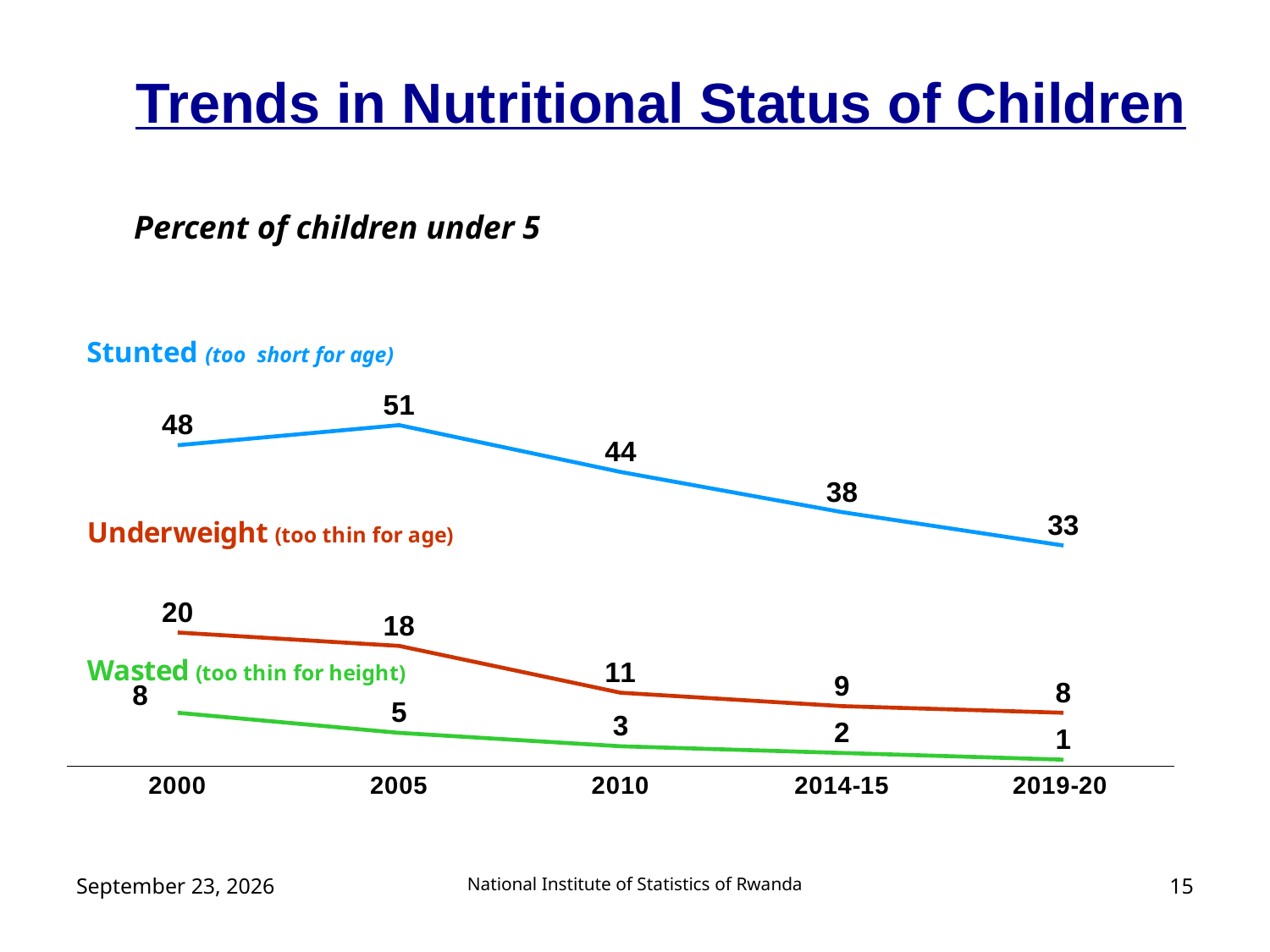
Does the wasted percentage rise or fall from 2000 to 2019-20? fall In which year is the underweight percentage lowest? 2019-20 What kind of chart is shown on the slide? line chart What is the underweight percentage in 2010? 11 In which year is the stunted percentage highest? 2005 Which is larger: the underweight percentage in 2005 or in 2014-15? 2005 What is the difference between the stunted percentage in 2000 and in 2019-20? 15 What is the wasted percentage in 2019-20? 1 How many series are plotted on the chart? 3 What colour is the line for the stunted series? blue How many time points are plotted on the x axis? 5 What is the stunted percentage in 2005? 51